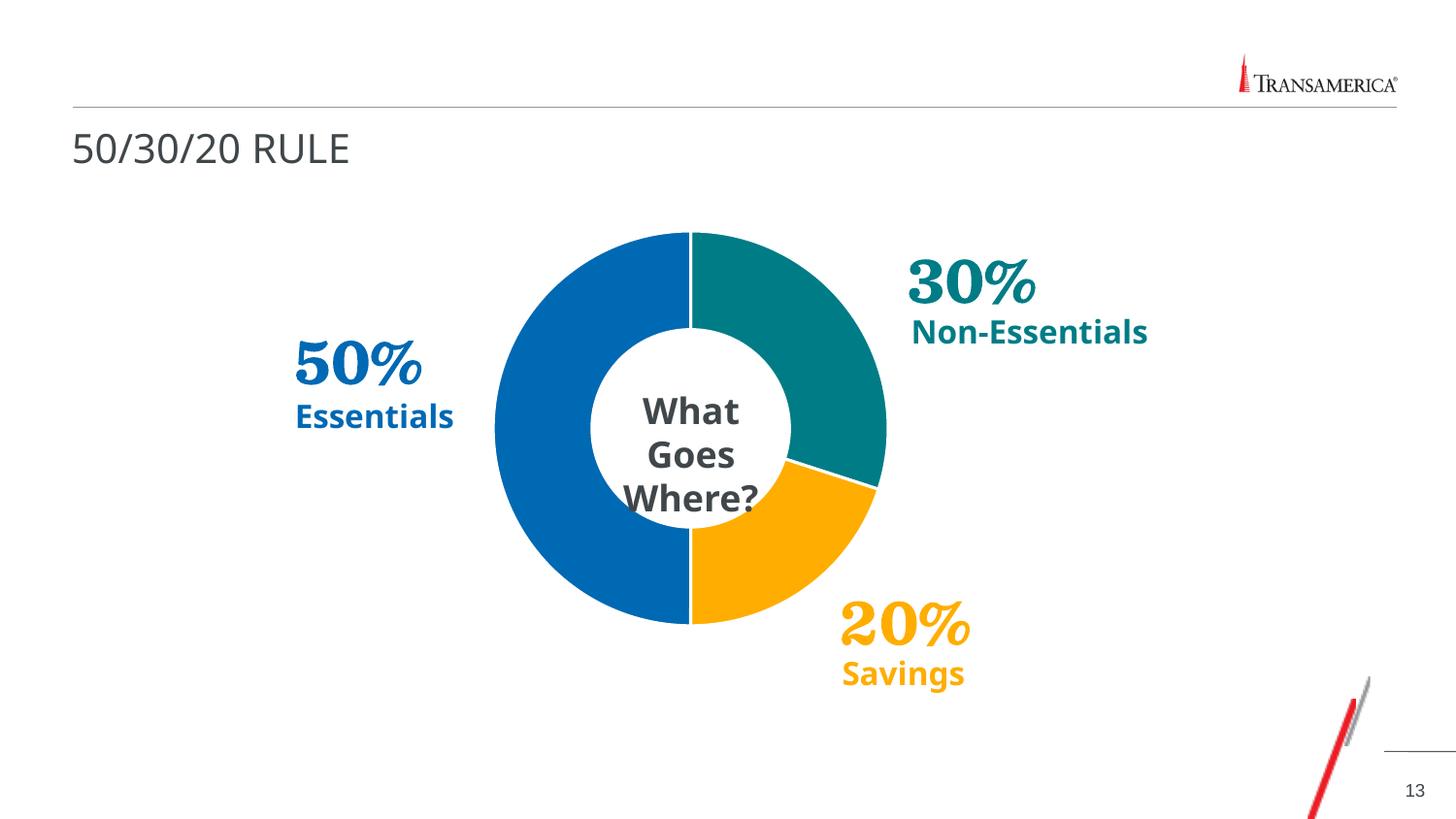
What is the difference between the Non-Essentials share and the Savings share? 10% What share of the donut chart is labelled Savings? 20% What is the difference between the Essentials share and the Savings share? 30% Which category has the largest slice of the chart? Essentials How many categories are shown in the chart? 3 What kind of chart is shown on the slide? Donut (pie) chart Which is larger, the Non-Essentials slice or the Savings slice? Non-Essentials What colour is the Savings slice of the chart? Orange/yellow What share of the donut chart is labelled Essentials? 50% What share of the donut chart is labelled Non-Essentials? 30% Which category has the smallest slice of the chart? Savings What text appears in the centre of the donut chart? What Goes Where?